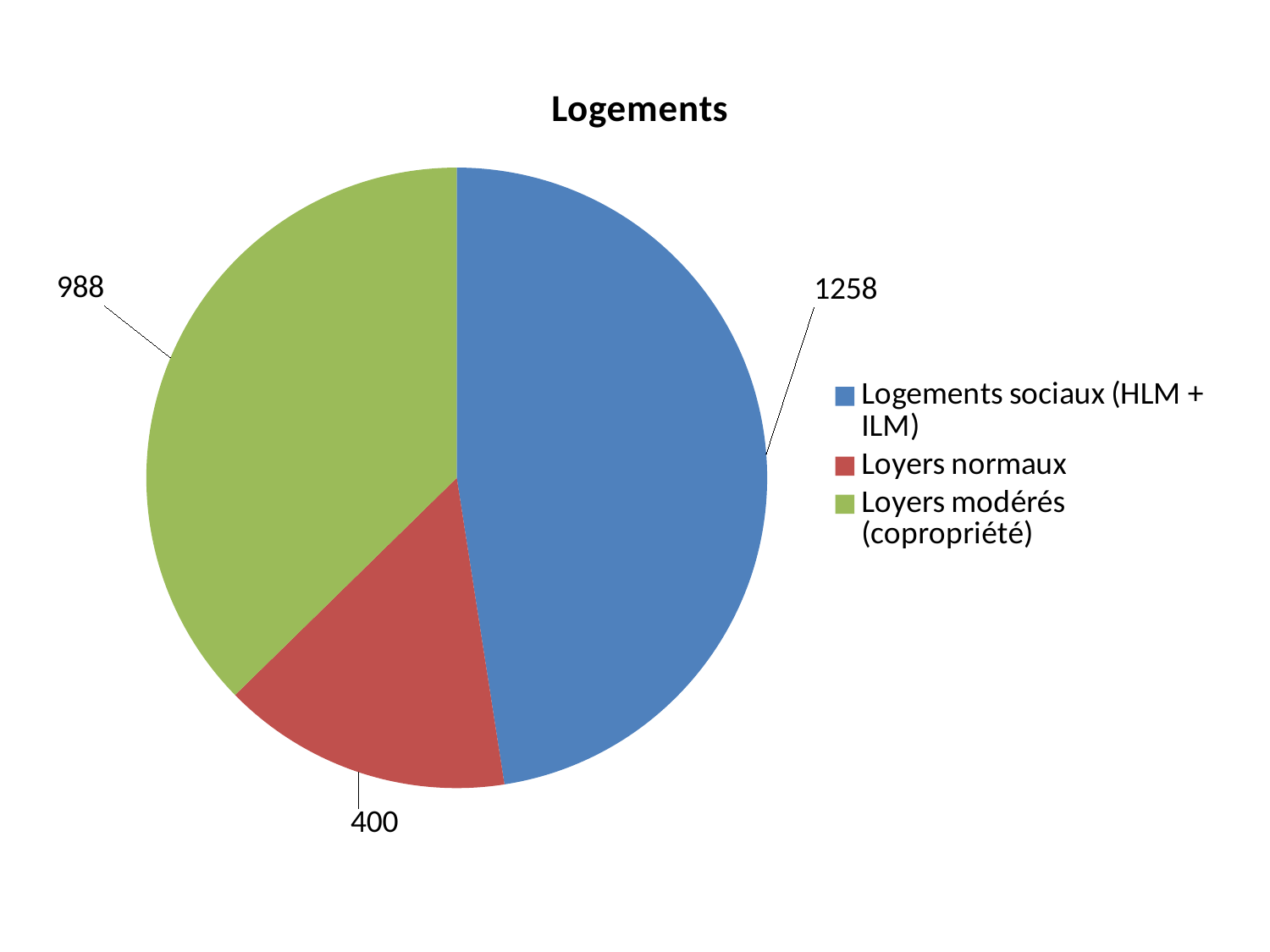
What is the value for Loyers modérés (copropriété)? 988 What is the title of the chart? Logements What is the value for Loyers normaux? 400 What is the total of all slices in the pie chart? 2646 What is the value for Logements sociaux (HLM + ILM)? 1258 Which category has the largest slice? Logements sociaux (HLM + ILM) Which category has the smallest slice? Loyers normaux Which is larger, Loyers normaux or Loyers modérés (copropriété)? Loyers modérés (copropriété) What kind of chart is shown on the slide? Pie chart What is the difference between Loyers modérés (copropriété) and Loyers normaux? 588 How many categories does the pie chart show? 3 What is the difference between Logements sociaux (HLM + ILM) and Loyers modérés (copropriété)? 270